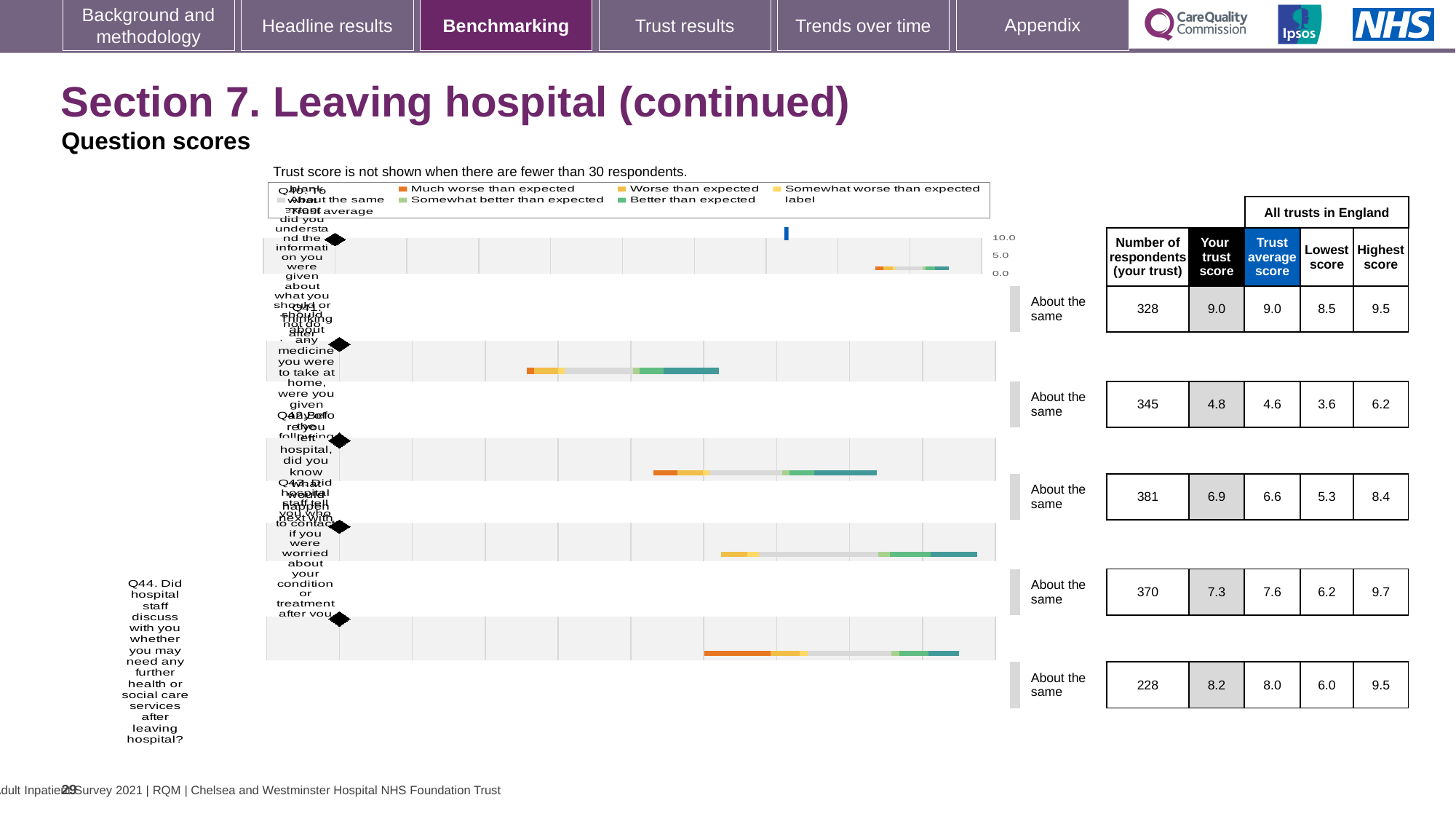
What is the highest score across all trusts in England for Q44? 9.5 What is the lowest score across all trusts in England for Q44? 6.0 What kind of chart is shown on the slide? bar chart What is the difference between the trust score and the trust average score for Q44? 0.2 What is the maximum value shown on the chart's score axis? 10.0 Is the trust score for Q44 greater or less than 5.0? greater How many respondents answered Q44 for this trust? 228 What is the trust score for Q44 (whether hospital staff discussed the need for further health or social care services after leaving hospital)? 8.2 How many question rows are plotted in the chart? 5 What is the trust average score for Q44? 8.0 What benchmark category is shown for Q44? About the same For Q44, which is larger: the trust score or the trust average score? trust score